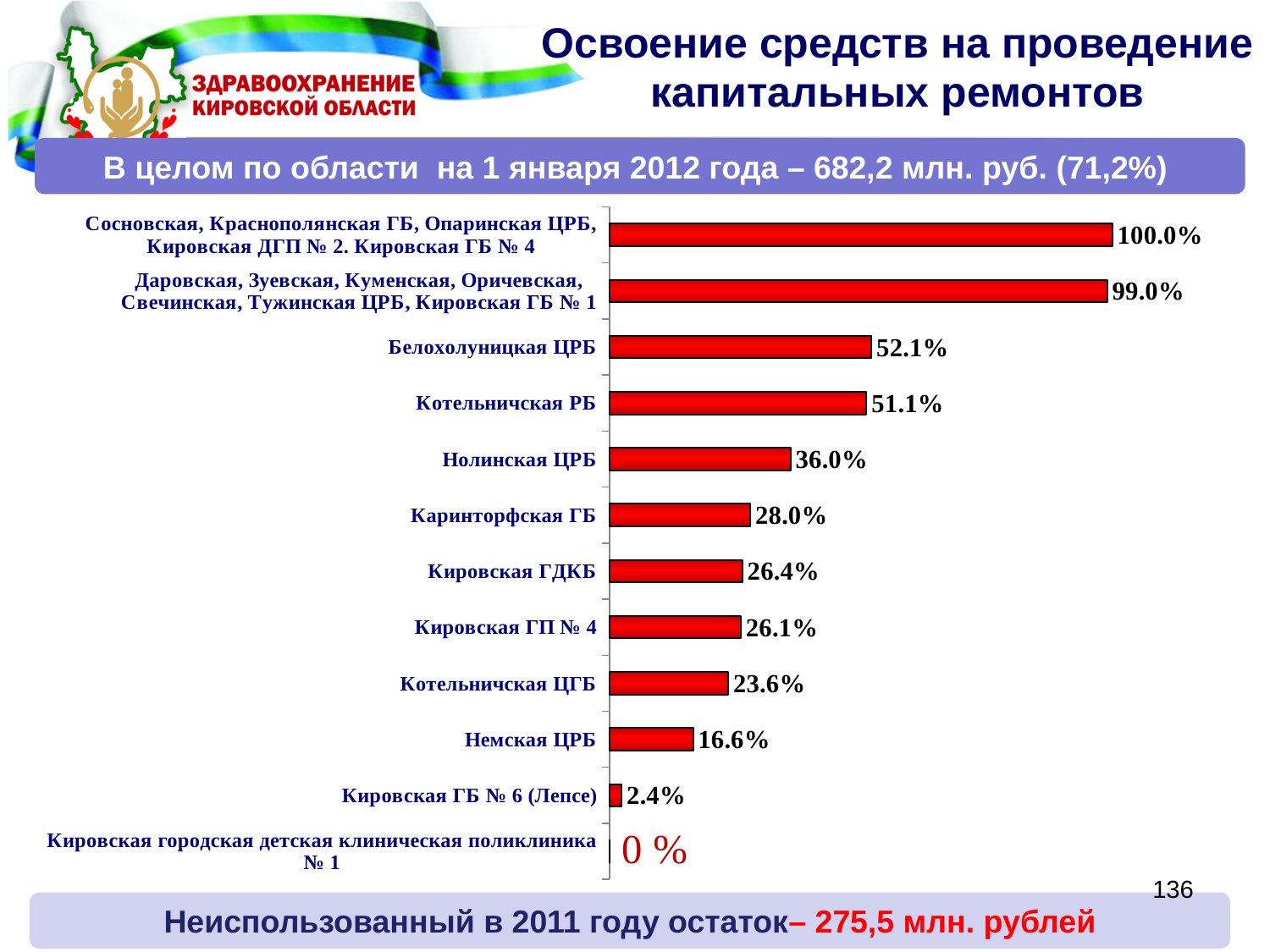
What colour are the bars in the chart? Red How many categories (bars) does the chart show? 12 What is the highest value shown on the chart? 100.0% What is the value for Кировская ГБ № 6 (Лепсе)? 2.4% What is the value for Белохолуницкая ЦРБ? 52.1% What is the value for Нолинская ЦРБ? 36.0% What kind of chart is shown on the slide? Bar chart Which category has the lowest value? Кировская городская детская клиническая поликлиника № 1 Which is larger, the value for Нолинская ЦРБ or the value for Каринторфская ГБ? Нолинская ЦРБ What is the value for Немская ЦРБ? 16.6% Do the bar values increase or decrease going from the top of the chart to the bottom? Decrease What is the difference between the values for Белохолуницкая ЦРБ and Котельничская РБ? 1.0%